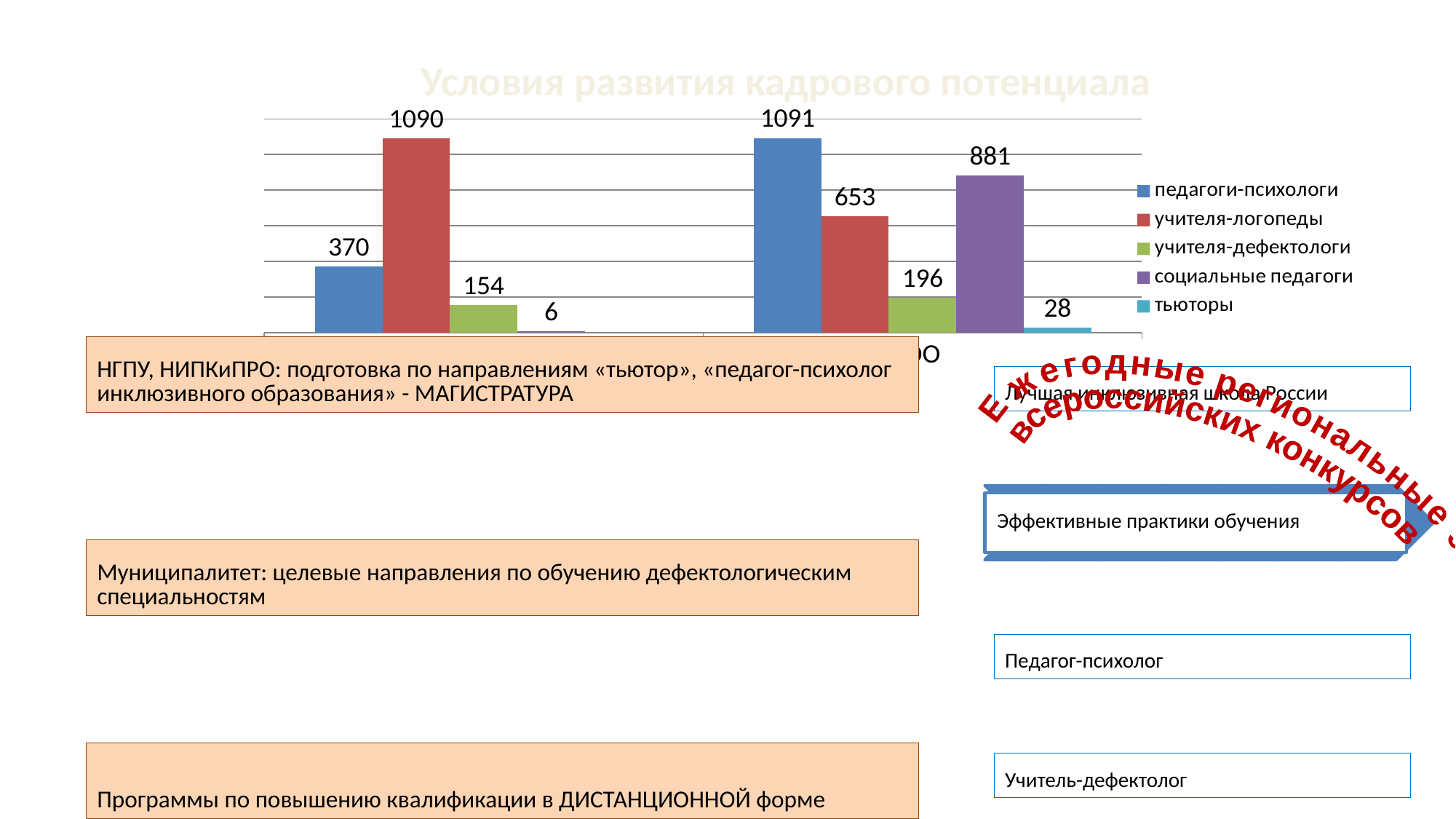
In the left group of bars, which series has the highest value? учителя-логопеды In the right group of bars, which series has the lowest value? тьюторы What kind of chart is shown on the slide? bar chart Is the value for учителя-дефектологи larger in the left group or the right group? right group What is the value for педагоги-психологи in the right group of bars? 1091 What is the title of the chart? Условия развития кадрового потенциала In the right group of bars, which series has the highest value? педагоги-психологи What is the value for тьюторы in the right group of bars? 28 What is the value for учителя-логопеды in the left group of bars? 1090 What is the value for социальные педагоги in the right group of bars? 881 How many series does the legend list? 5 What is the difference between the учителя-логопеды value in the left group (1090) and in the right group (653)? 437